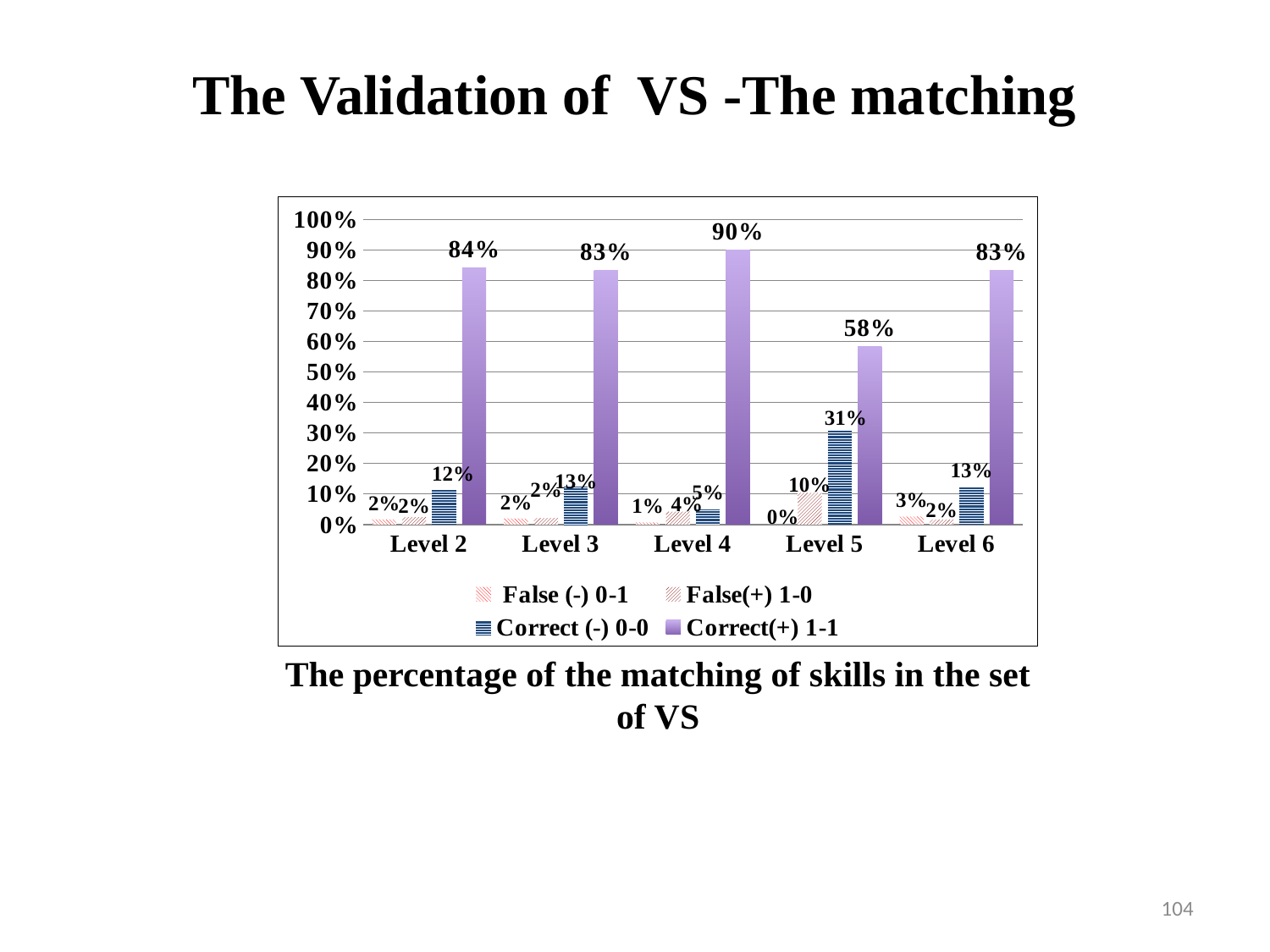
Which level has the lowest Correct(+) 1-1 value? Level 5 What is the value of Correct(+) 1-1 for Level 5? 58% How many series does the legend list? 4 What is the value of Correct (-) 0-0 for Level 5? 31% Which is larger, the Correct (-) 0-0 value for Level 5 or for Level 2? Level 5 What is the value of Correct(+) 1-1 for Level 4? 90% Which level has the highest Correct(+) 1-1 value? Level 4 What is the difference between the Correct(+) 1-1 values for Level 4 and Level 5? 32% What kind of chart is shown on the slide? Bar chart How many levels are shown on the x axis? 5 What is the caption below the chart? The percentage of the matching of skills in the set of VS What is the value of False(+) 1-0 for Level 5? 10%